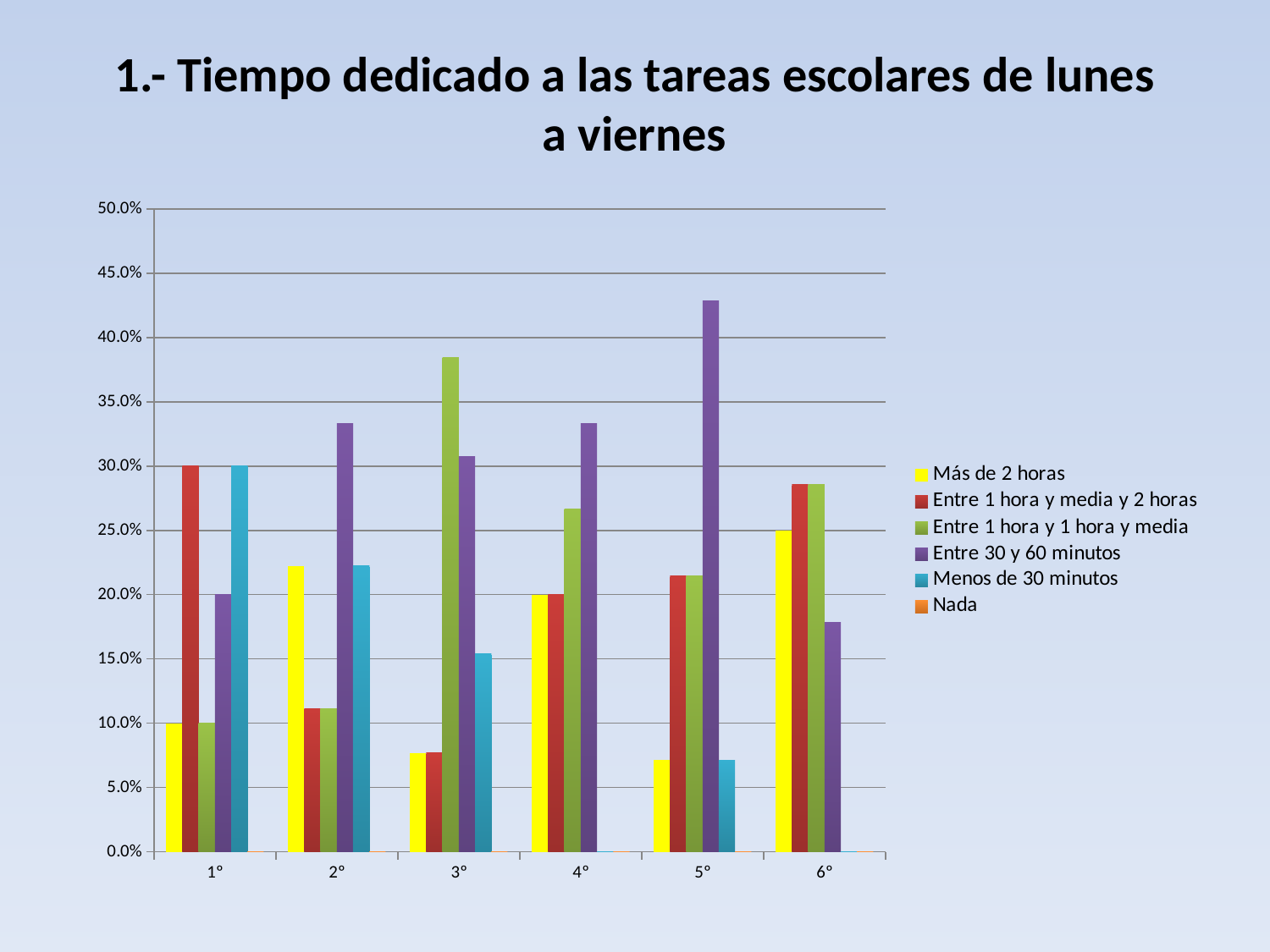
Which is larger at 6°: 'Más de 2 horas' or 'Entre 30 y 60 minutos'? Más de 2 horas Is the value for 'Entre 1 hora y 1 hora y media' at 3° greater or less than 35%? greater How many series does the legend list? 6 Which series has the tallest bar for 3°? Entre 1 hora y 1 hora y media What is the title of the chart? 1.- Tiempo dedicado a las tareas escolares de lunes a viernes Which series has the tallest bar for 5°? Entre 30 y 60 minutos Is the value for 'Menos de 30 minutos' at 3° greater or less than 20%? less Which series has the lowest values across all grades? Nada How many grade categories are shown on the x axis? 6 What kind of chart is shown on the slide? bar chart Is the value for 'Entre 30 y 60 minutos' at 5° greater or less than 40%? greater Which is larger at 2°: 'Entre 30 y 60 minutos' or 'Más de 2 horas'? Entre 30 y 60 minutos